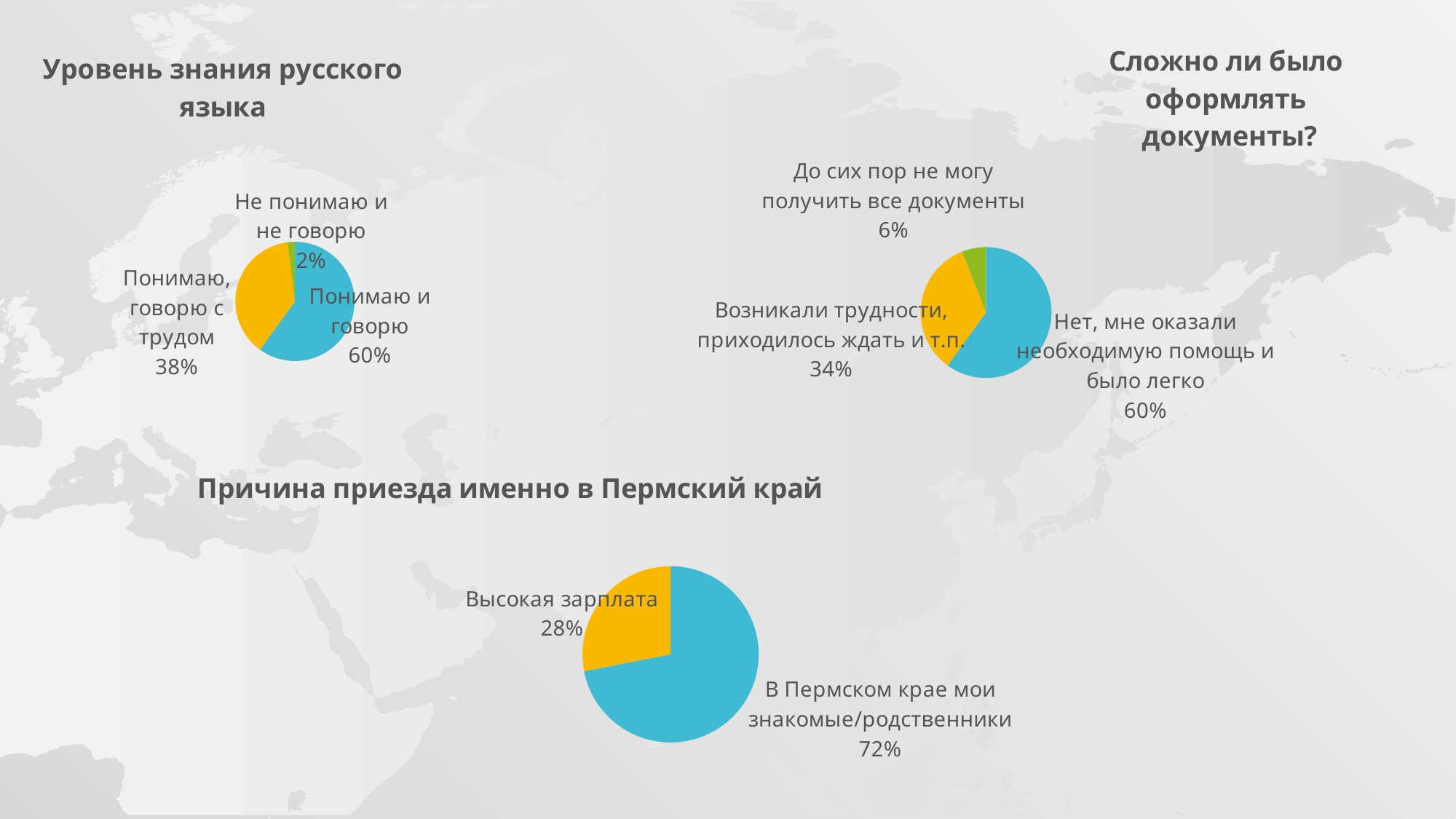
In the chart titled "Уровень знания русского языка", what share is labelled "Не понимаю и не говорю"? 2% In the chart titled "Причина приезда именно в Пермский край", what is the difference between the two slices? 44% In the chart titled "Уровень знания русского языка", what share is labelled "Понимаю и говорю"? 60% In the chart titled "Сложно ли было оформлять документы?", what share is labelled "Возникали трудности, приходилось ждать и т.п."? 34% In the chart titled "Уровень знания русского языка", which category has the smallest slice? Не понимаю и не говорю In the chart titled "Причина приезда именно в Пермский край", what share is labelled "Высокая зарплата"? 28% What kind of chart is used in the chart titled "Причина приезда именно в Пермский край"? Pie chart In the chart titled "Сложно ли было оформлять документы?", what is the difference between the "Нет, мне оказали необходимую помощь и было легко" share and the "До сих пор не могу получить все документы" share? 54% In the chart titled "Причина приезда именно в Пермский край", which is larger: "Высокая зарплата" or "В Пермском крае мои знакомые/родственники"? В Пермском крае мои знакомые/родственники In the chart titled "Сложно ли было оформлять документы?", which category has the largest slice? Нет, мне оказали необходимую помощь и было легко How many pie charts are shown on the slide? 3 In the chart titled "Уровень знания русского языка", how many slices does the pie have? 3